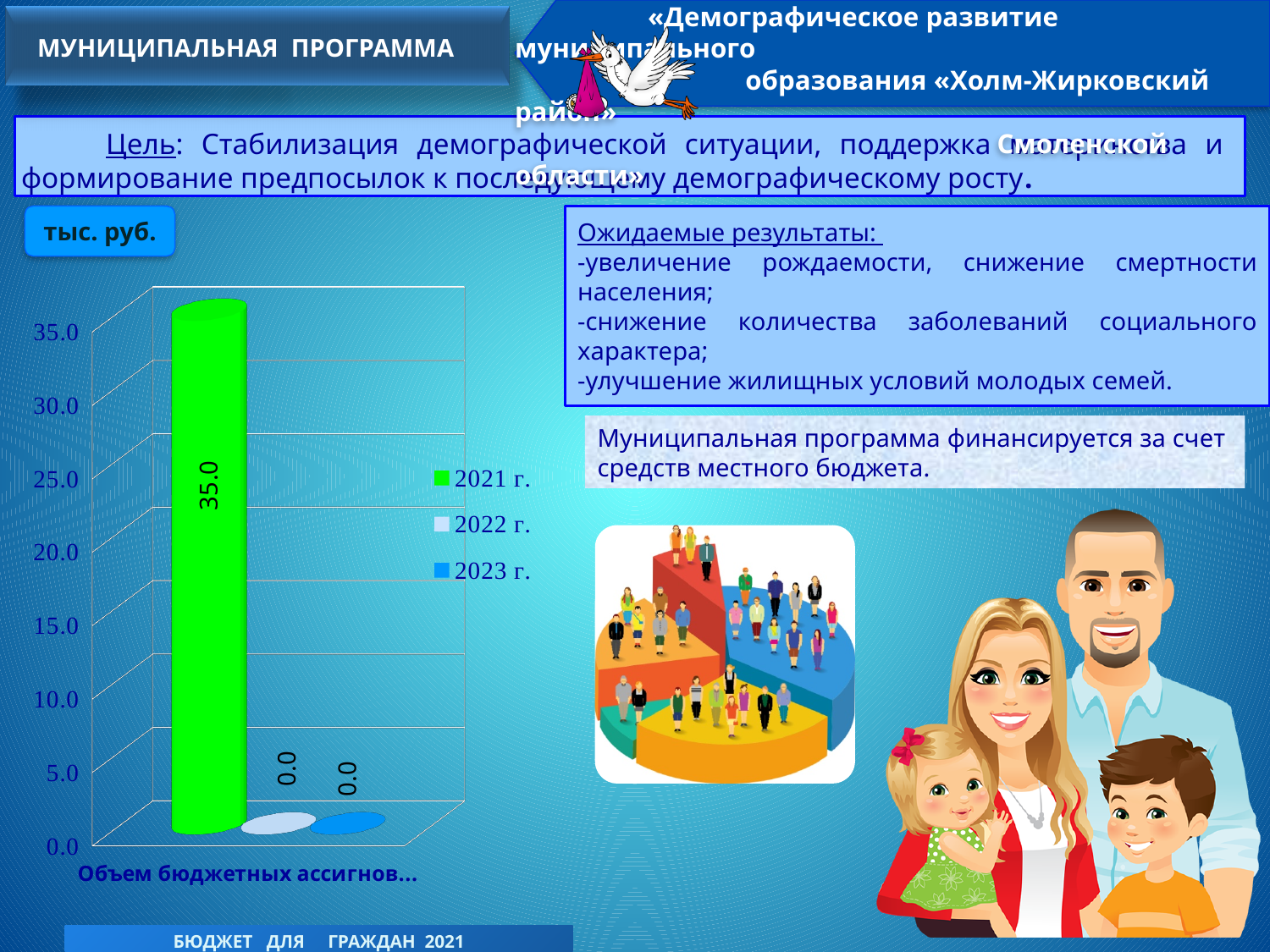
What is the value for 2022 г. in the chart? 0.0 What colour is the bar for 2021 г. in the chart? green What is the difference between the values for 2021 г. and 2022 г.? 35.0 Which is larger, the value for 2021 г. or the value for 2023 г.? 2021 г. What unit is indicated for the chart values? тыс. руб. What is the value for 2023 г. in the chart? 0.0 How many series does the chart legend list? 3 What is the total of the values for 2021 г., 2022 г. and 2023 г.? 35.0 Which year has the highest value in the chart? 2021 г. What kind of chart is shown on the slide? bar chart Is the value for 2021 г. greater or less than 30.0? greater What is the value for 2021 г. in the chart? 35.0